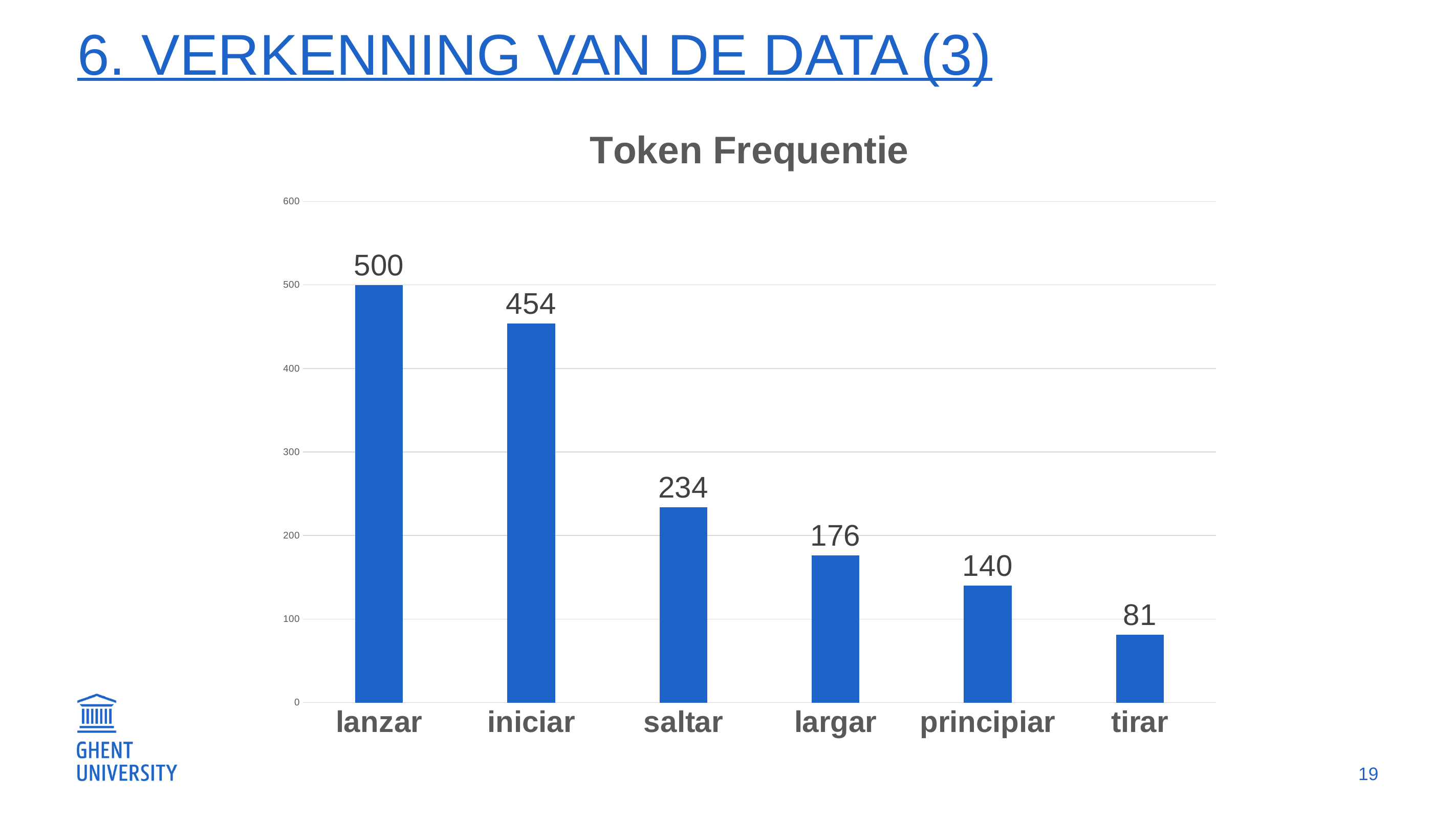
Which is larger, the value for saltar or the value for largar? saltar What is the value for tirar? 81 What kind of chart is shown on the slide? bar chart Is the value for principiar greater or less than 200? less What is the difference between the values for largar and principiar? 36 What is the title of the chart? Token Frequentie What is the value for lanzar? 500 Which category has the lowest value? tirar How many categories are shown on the x axis? 6 Which category has the highest value? lanzar What is the value for saltar? 234 What is the difference between the values for lanzar and iniciar? 46